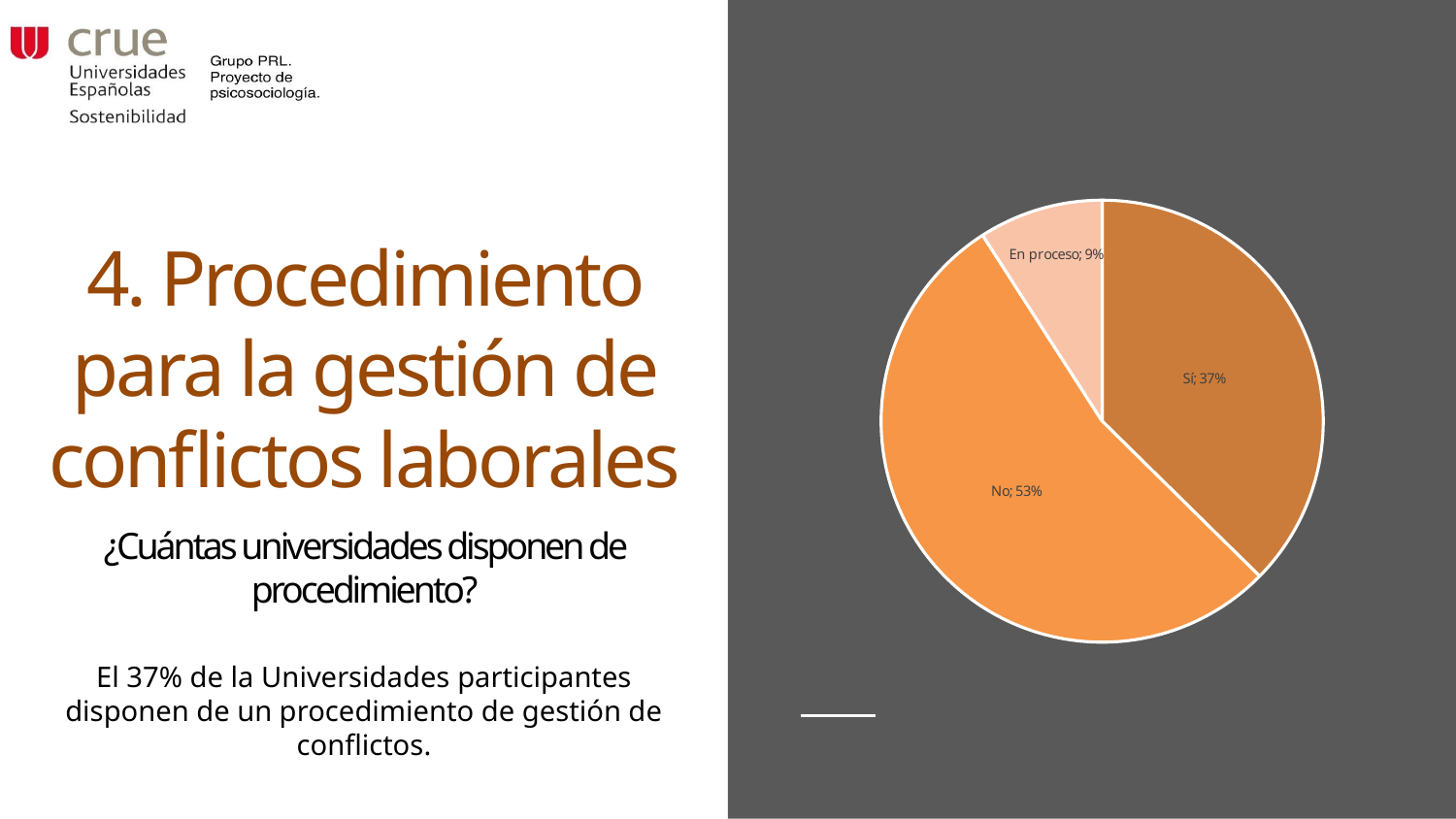
What is the difference in percentage points between "Sí" and "En proceso"? 28 Which is larger, the share for "Sí" or the share for "En proceso"? Sí Is the share for "No" greater or less than 50%? greater What percentage of universities answered "No"? 53% Which category has the largest share of the pie? No What kind of chart is shown on the slide? pie chart What percentage is shown for "En proceso"? 9% Which slice of the pie is the lightest in colour? En proceso What percentage of universities answered "Sí"? 37% What is the difference in percentage points between "No" and "Sí"? 16 How many slices does the pie chart have? 3 Which category has the smallest share of the pie? En proceso